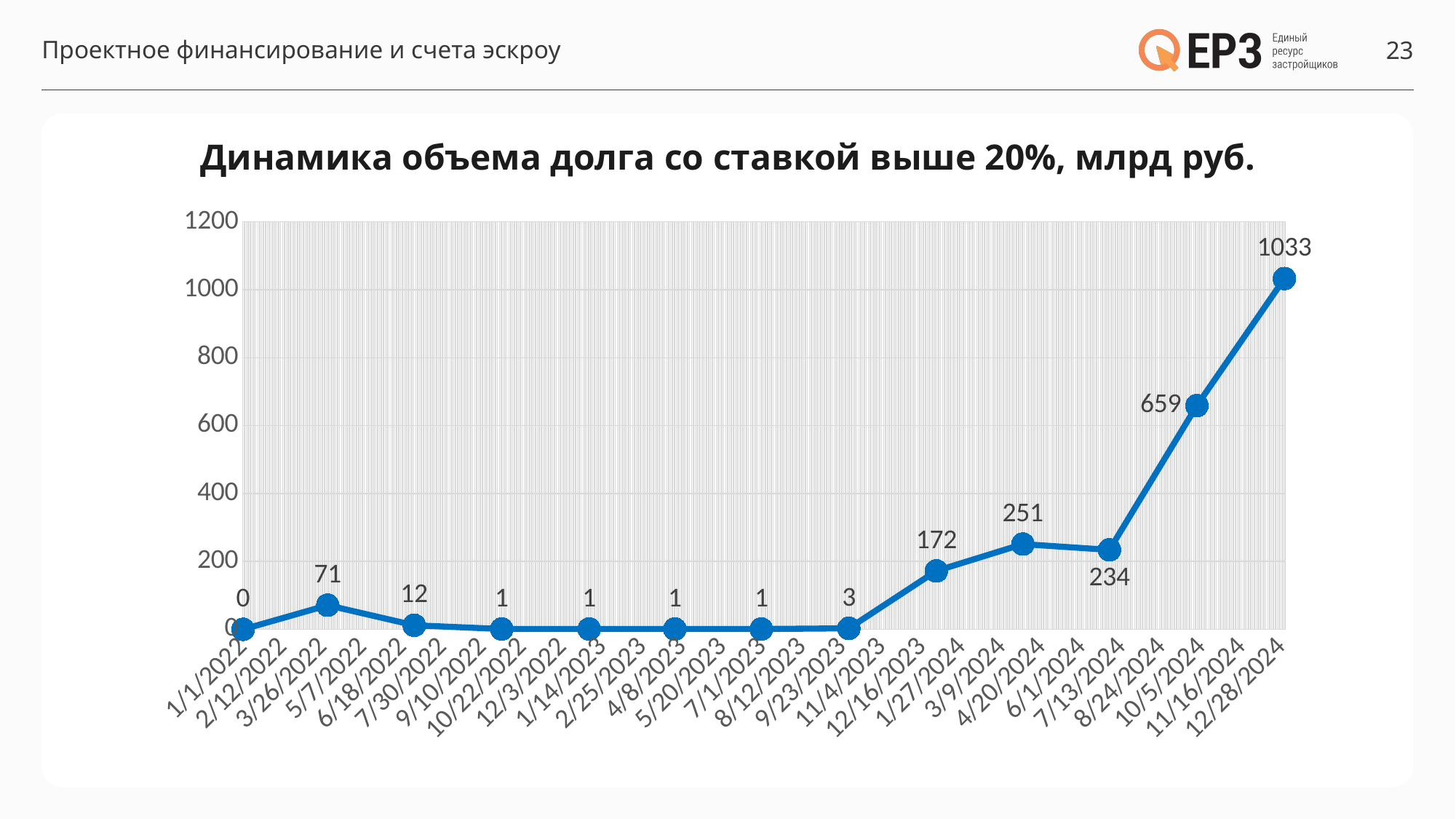
Which is larger, the second data point or the third data point on the line? the second data point (71) What is the value of the second data point on the line? 71 How many data points are plotted on the line? 13 What is the title of the chart? Динамика объема долга со ставкой выше 20%, млрд руб. Overall, do the values rise or fall from left to right along the x axis? rise What is the highest value plotted on the chart? 1033 What is the lowest value plotted on the chart? 0 What is the difference between the last data point (1033) and the one before it (659)? 374 What is the difference between the data point labeled 251 and the following point labeled 234? 17 What kind of chart is shown on the slide? line chart What is the value of the last (rightmost) data point on the line? 1033 What is the value of the first (leftmost) data point on the line? 0